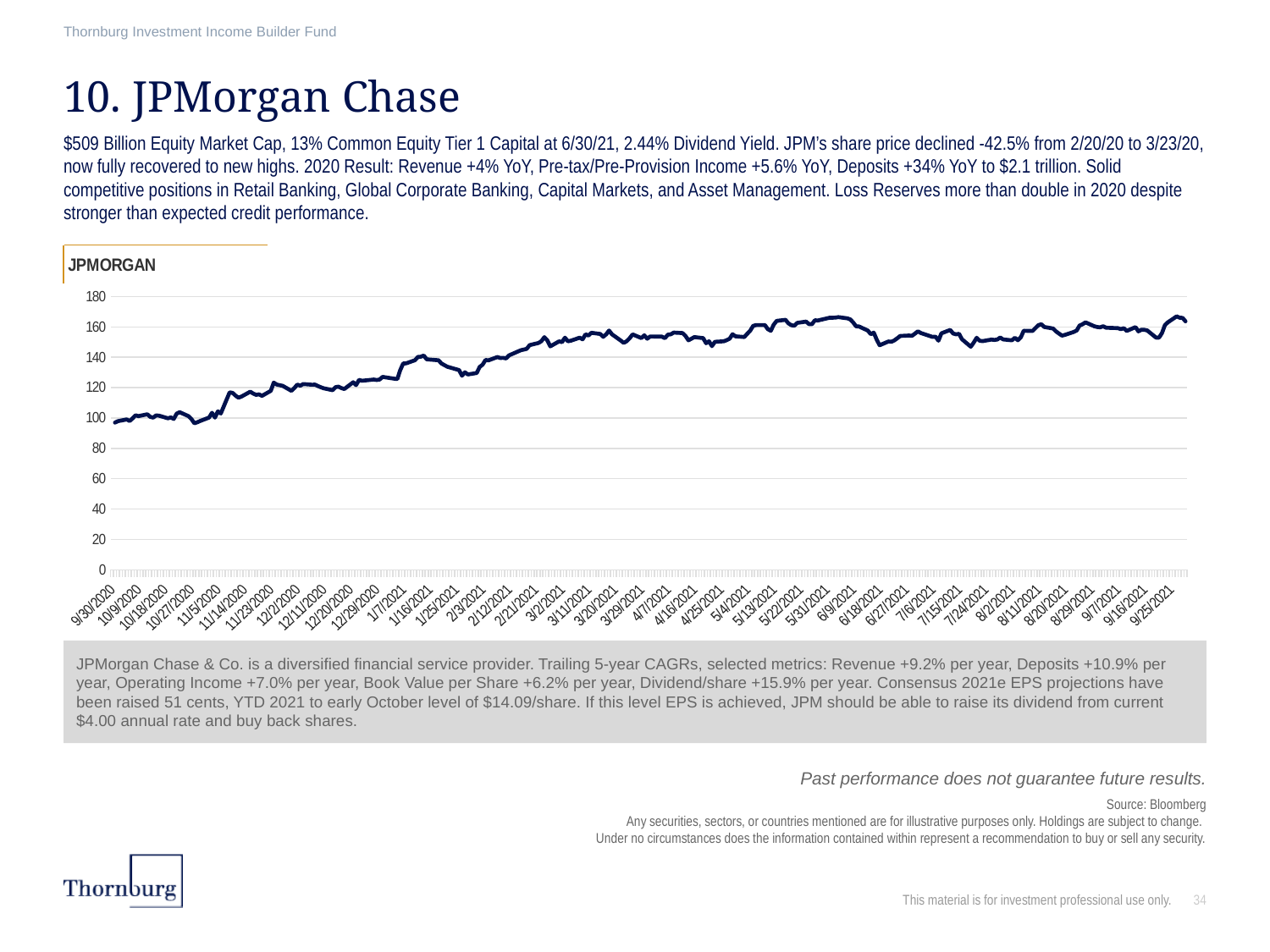
What is the title of the chart? JPMORGAN Which is larger, the value for 9/30/2020 or the value for 9/25/2021? 9/25/2021 What is the highest value shown on the y axis of the chart? 180 Overall, do the values in the JPMORGAN chart rise or fall from left to right along the x axis? rise Is the value for 3/2/2021 greater or less than 140? greater Is the value for 5/31/2021 greater or less than 140? greater Is the value for 11/5/2020 greater or less than 120? less What is the first date label on the x axis of the chart? 9/30/2020 Which is larger, the value for 11/5/2020 or the value for 3/2/2021? 3/2/2021 What kind of chart is shown on the slide? line chart